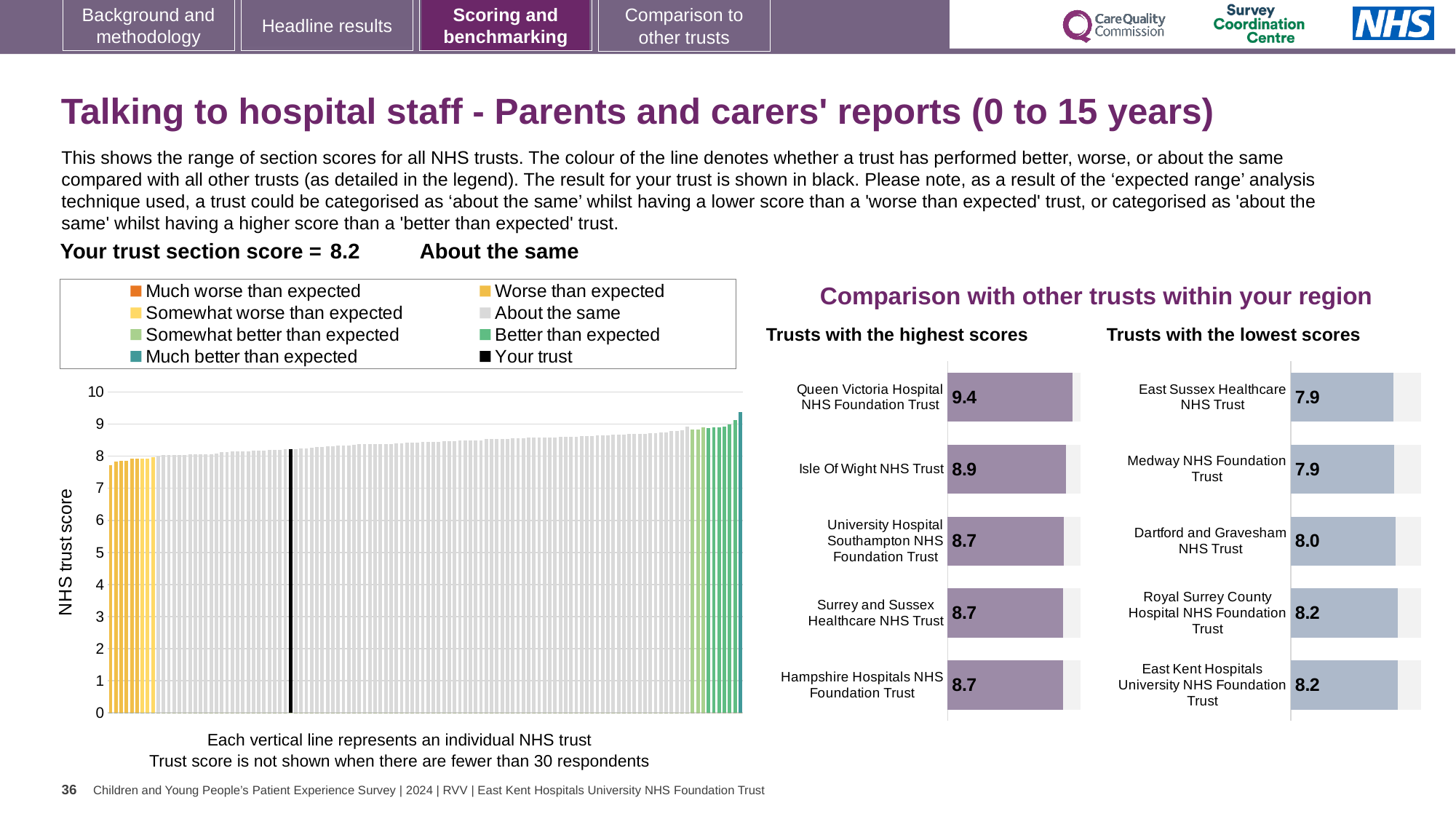
In the large 'NHS trust score' chart, do the bar values rise or fall from left to right? Rise In the 'Trusts with the highest scores' chart, which trust has the highest score? Queen Victoria Hospital NHS Foundation Trust How many trusts are shown in the 'Trusts with the lowest scores' chart? 5 In the 'Trusts with the highest scores' chart, what is the score for Queen Victoria Hospital NHS Foundation Trust? 9.4 In the 'Trusts with the lowest scores' chart, what is the score for Dartford and Gravesham NHS Trust? 8.0 How many entries does the legend of the large 'NHS trust score' chart list? 8 What kind of chart is the large chart on the left with the y-axis labelled 'NHS trust score'? Bar chart In the 'Trusts with the lowest scores' chart, what is the difference between the scores of Royal Surrey County Hospital NHS Foundation Trust and Medway NHS Foundation Trust? 0.3 Which is larger: the score for Queen Victoria Hospital NHS Foundation Trust in the highest scores chart, or the score for East Sussex Healthcare NHS Trust in the lowest scores chart? Queen Victoria Hospital NHS Foundation Trust In the 'Trusts with the highest scores' chart, what is the score for Isle Of Wight NHS Trust? 8.9 In the 'Trusts with the lowest scores' chart, what is the score for East Kent Hospitals University NHS Foundation Trust? 8.2 In the 'Trusts with the highest scores' chart, what is the difference between the scores of Queen Victoria Hospital NHS Foundation Trust and Isle Of Wight NHS Trust? 0.5